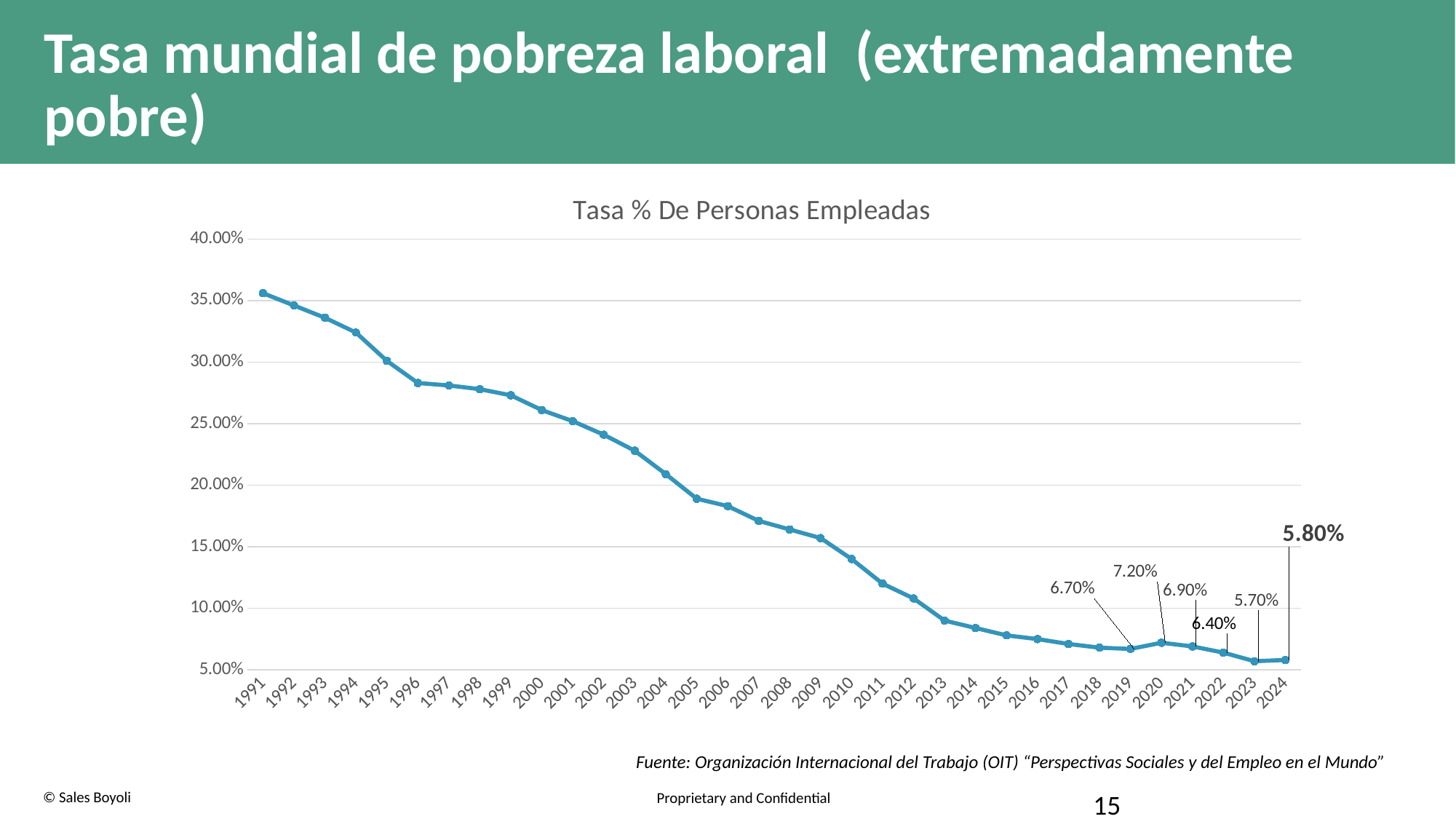
What is the value for 2020? 7.20% What is the value for 2024? 5.80% What is the value for 2022? 6.40% What kind of chart is shown on the slide? line chart Which year has the highest value on the chart? 1991 Which year has the lowest value on the chart? 2023 Do the values generally rise or fall from 1991 to 2024? fall What is the value for 2019? 6.70% What is the difference between the values for 2020 and 2023? 1.50% What is the chart's title? Tasa % De Personas Empleadas Which is larger, the value for 2021 or the value for 2019? 2021 Is the value for 2005 greater or less than 20.00%? less